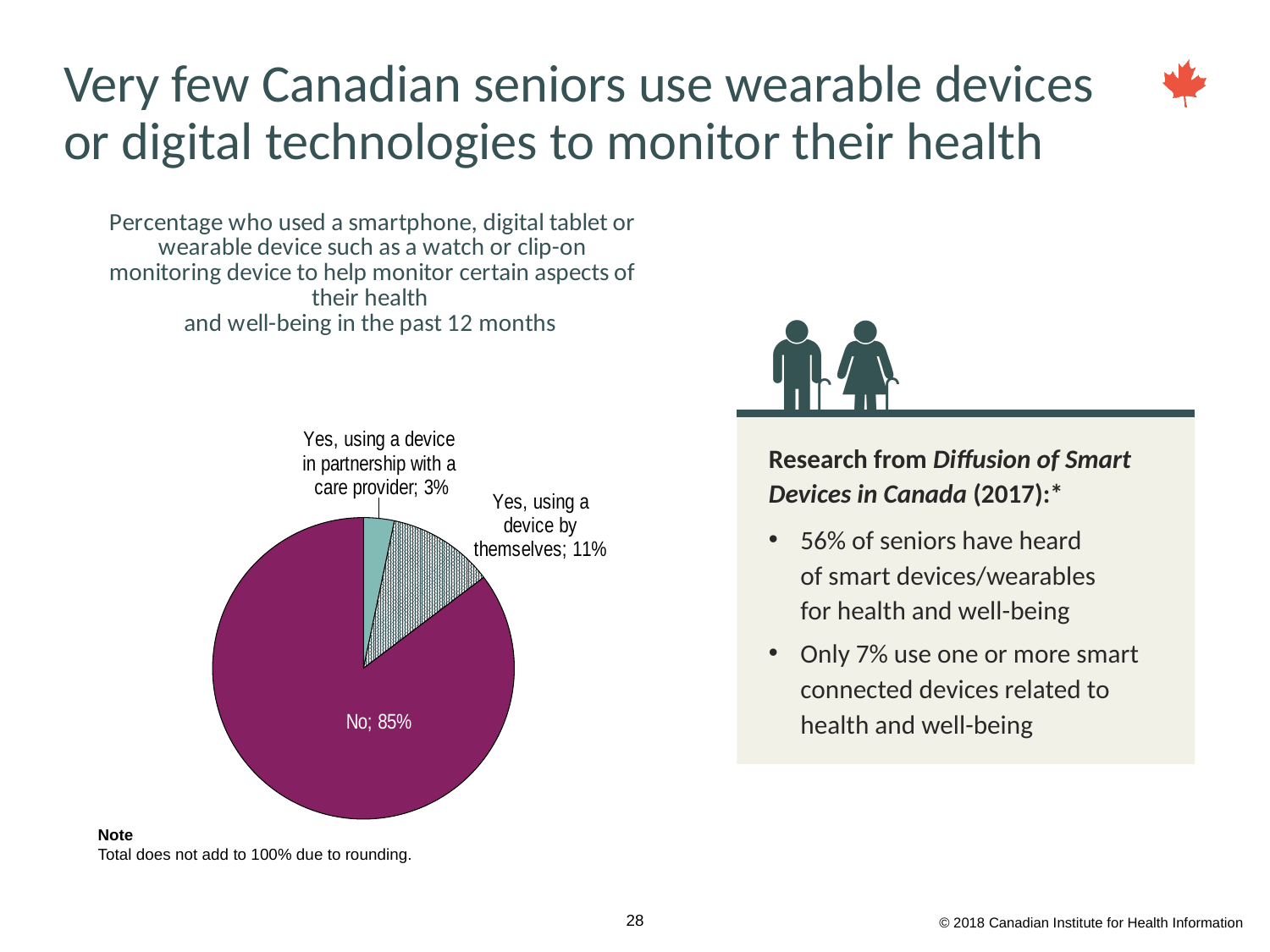
What percentage answered "Yes, using a device in partnership with a care provider"? 3% What is the combined share of the two "Yes" categories? 14% What is the difference between the "No" share and the "Yes, using a device by themselves" share? 74 percentage points Which is larger: "Yes, using a device by themselves" or "Yes, using a device in partnership with a care provider"? Yes, using a device by themselves What colour is the "No" slice of the pie? purple According to the note, why does the total not add to 100%? Due to rounding How many slices does the pie chart have? 3 What percentage answered "Yes, using a device by themselves"? 11% Which category has the largest share of the pie? No What type of chart is shown on the slide? pie chart What percentage of respondents answered "No"? 85% Which category has the smallest share of the pie? Yes, using a device in partnership with a care provider